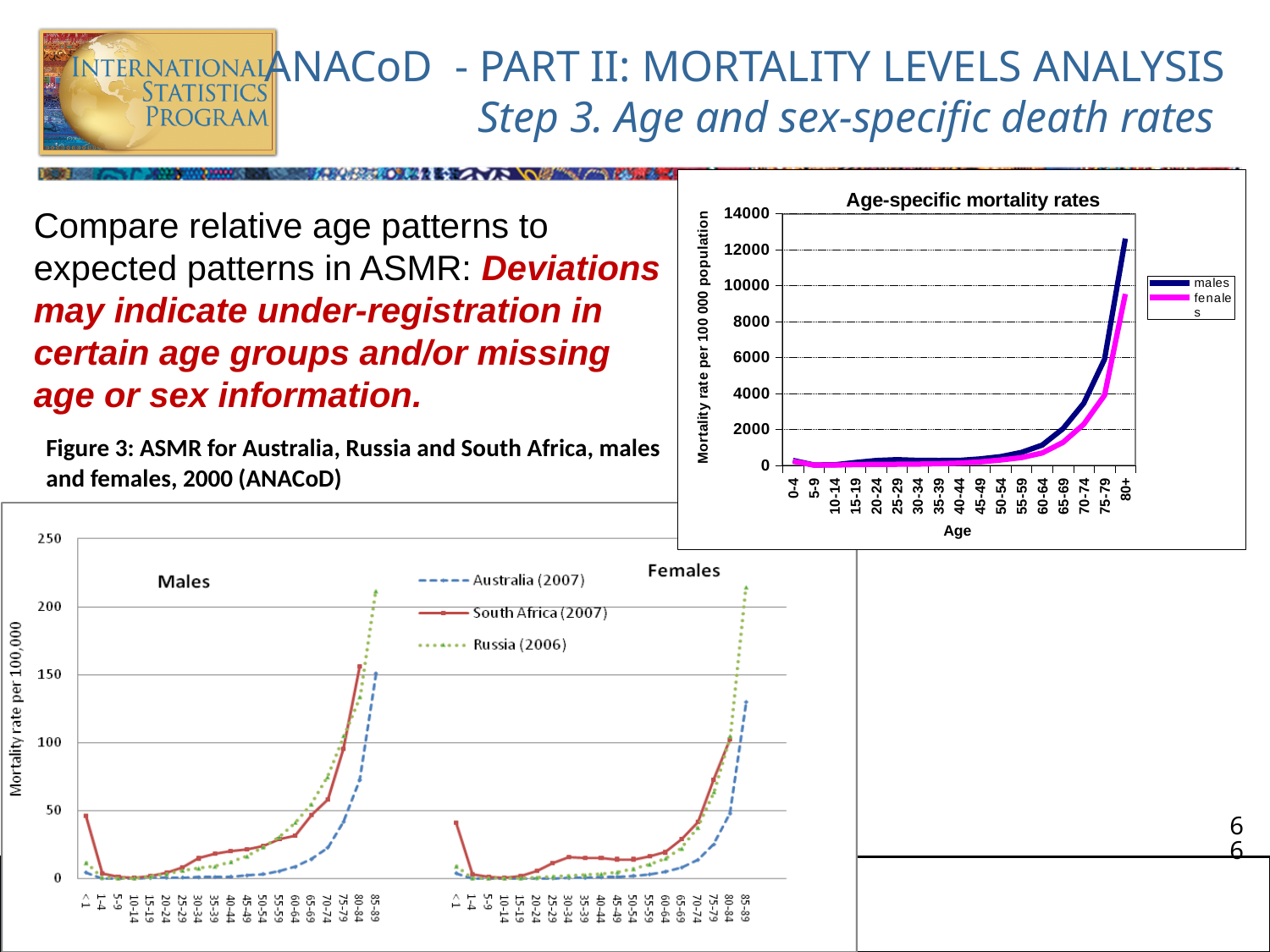
What is the y-axis label of the 'Age-specific mortality rates' chart? Mortality rate per 100 000 population In the 'Age-specific mortality rates' chart, is the value for males at age 70-74 greater or less than 6000? less In the 'Age-specific mortality rates' chart, which series has the higher value at age 80+, males or females? males In the 'Age-specific mortality rates' chart, is the value for males at age 80+ greater or less than 10000? greater How many series does the legend of the 'Age-specific mortality rates' chart list? 2 How many series does the legend of the Figure 3 chart at the bottom of the slide list? 3 How many age groups are shown on the x axis of the 'Age-specific mortality rates' chart? 17 What type of chart is the 'Age-specific mortality rates' chart at the top right of the slide? Line chart In the Males panel of the Figure 3 chart at the bottom of the slide, which series has the highest value at age 85-89? Russia (2006) In the 'Age-specific mortality rates' chart, is the value for females at age 80+ greater or less than 10000? less In the 'Age-specific mortality rates' chart, do the mortality rates generally rise or fall as age increases from 20-24 to 80+? rise